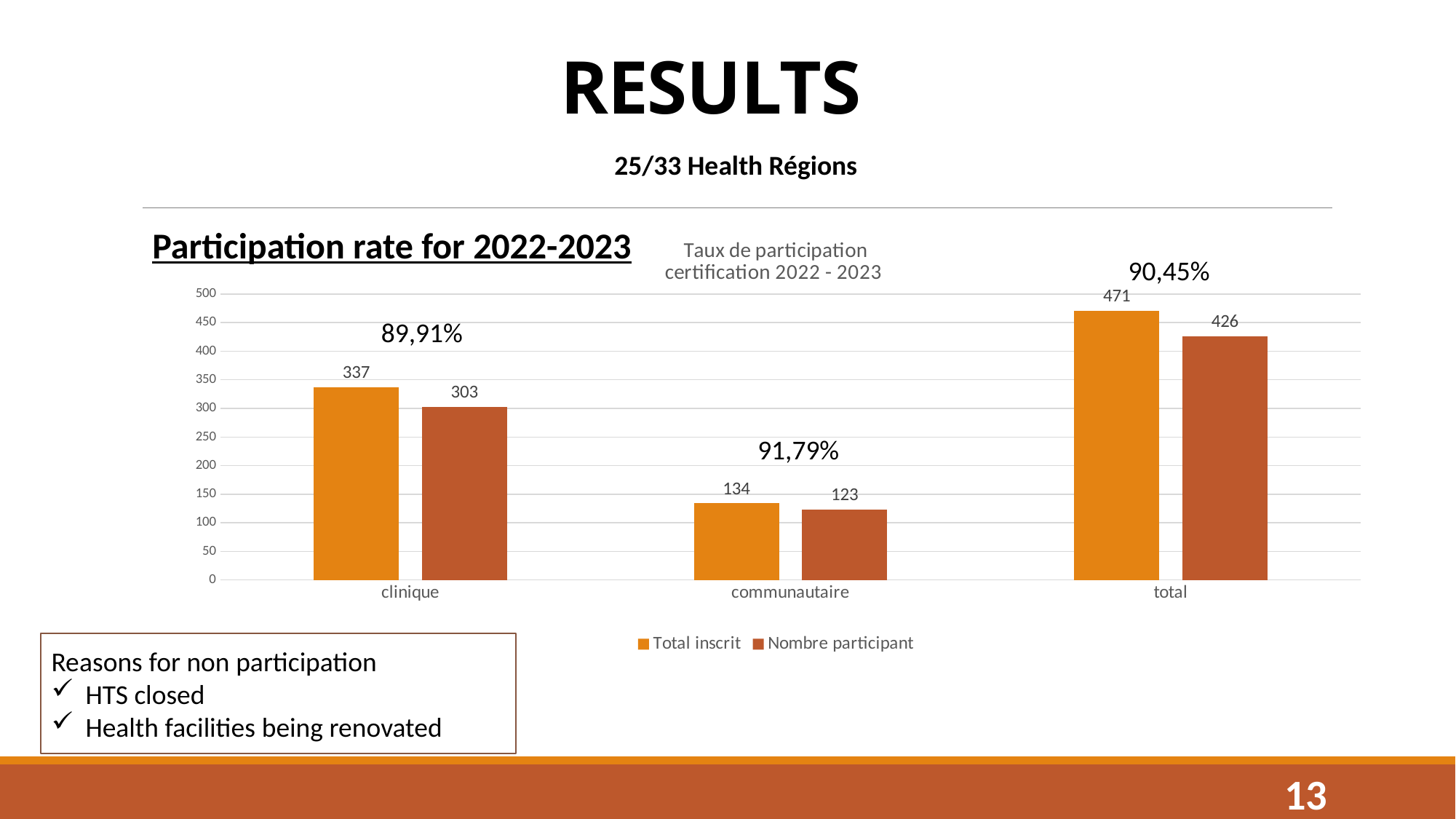
What is the difference between Total inscrit and Nombre participant for clinique? 34 What participation rate is shown above the communautaire bars? 91,79% How many series does the legend list? 2 How many categories are shown on the x axis? 3 What is the value of Total inscrit for clinique? 337 Which category has the highest Nombre participant value? total Which is larger for communautaire: Total inscrit or Nombre participant? Total inscrit Is the Nombre participant value for total greater or less than 400? greater What is the value of Total inscrit for total? 471 What is the value of Nombre participant for communautaire? 123 Which category has the lowest Total inscrit value? communautaire What kind of chart is shown on the slide? bar chart